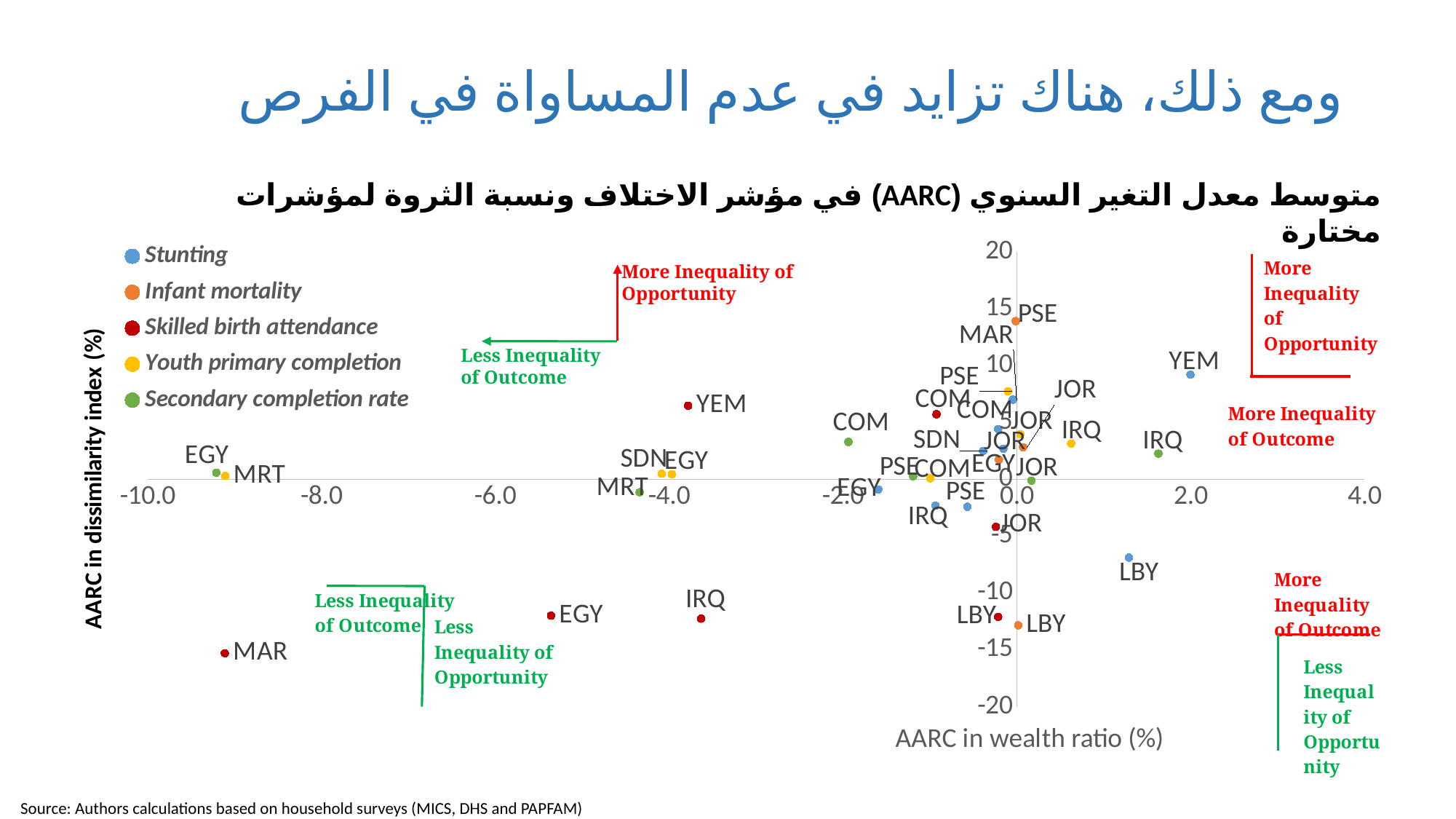
What kind of chart is shown on the slide? Scatter chart Is the AARC in dissimilarity index for the Skilled birth attendance point labelled EGY greater or less than -5? less What is the title of the vertical axis? AARC in dissimilarity index (%) Is the AARC in dissimilarity index for the Infant mortality point labelled PSE greater or less than 10? greater What is the title of the horizontal axis? AARC in wealth ratio (%) Among the Skilled birth attendance points, which has the higher AARC in dissimilarity index: YEM or IRQ? YEM Is the AARC in wealth ratio for the Skilled birth attendance point labelled MAR greater or less than -8.0? less Which Skilled birth attendance point has the lowest AARC in wealth ratio? MAR How many series does the legend list? 5 Which Stunting point has the highest AARC in dissimilarity index? YEM